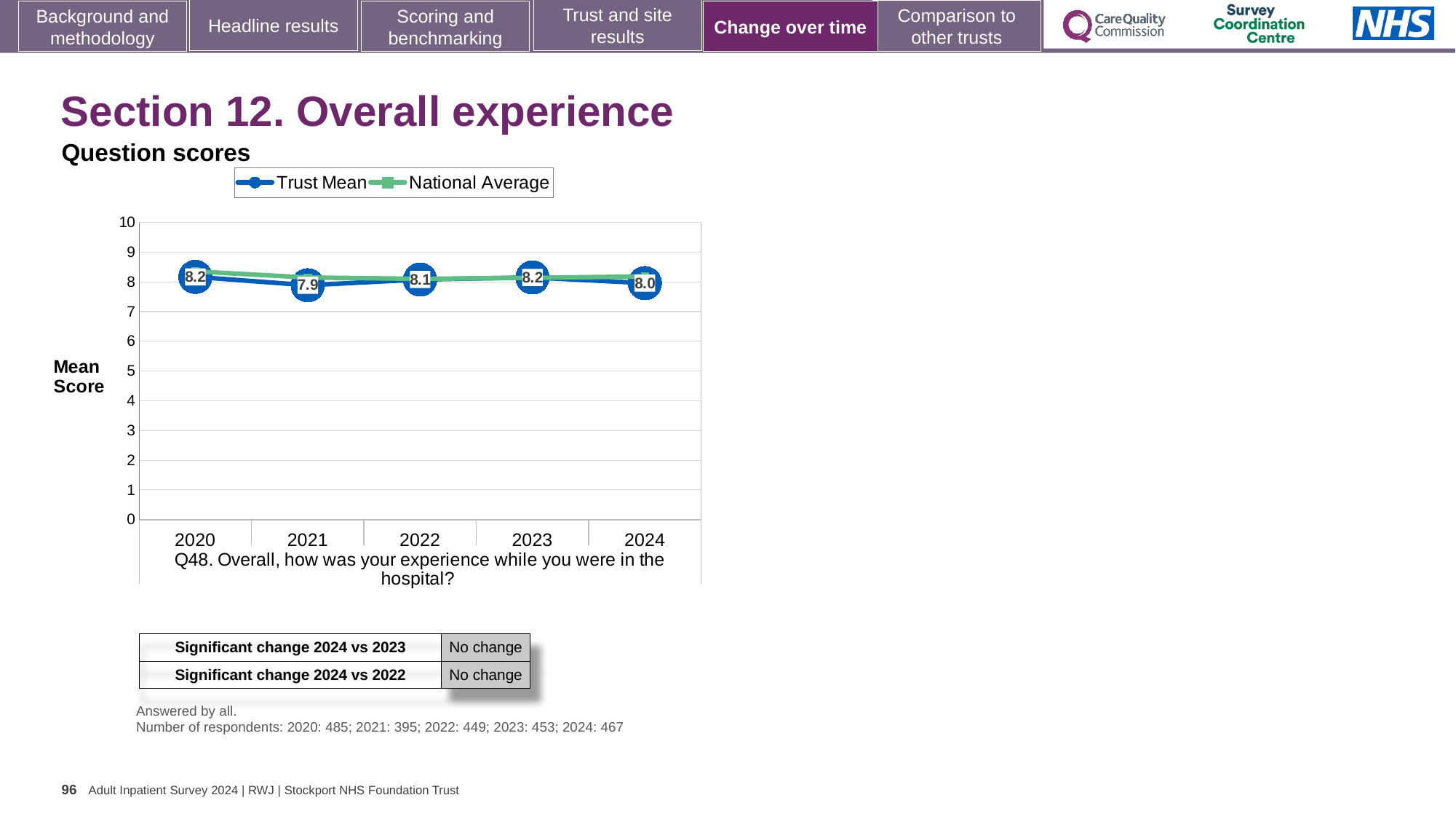
In which year is the Trust Mean score lowest? 2021 How many years are plotted on the x axis? 5 What is the label on the y axis of the chart? Mean Score What kind of chart is shown? line chart Is the National Average value for 2022 greater or less than 7? greater What is the Trust Mean score for 2021? 7.9 Does the Trust Mean score rise or fall from 2023 to 2024? fall What is the Trust Mean score for 2024? 8.0 Which year has the higher Trust Mean score, 2021 or 2023? 2023 How many series does the legend list? 2 What is the difference between the Trust Mean scores for 2020 and 2021? 0.3 What is the Trust Mean score for 2022? 8.1